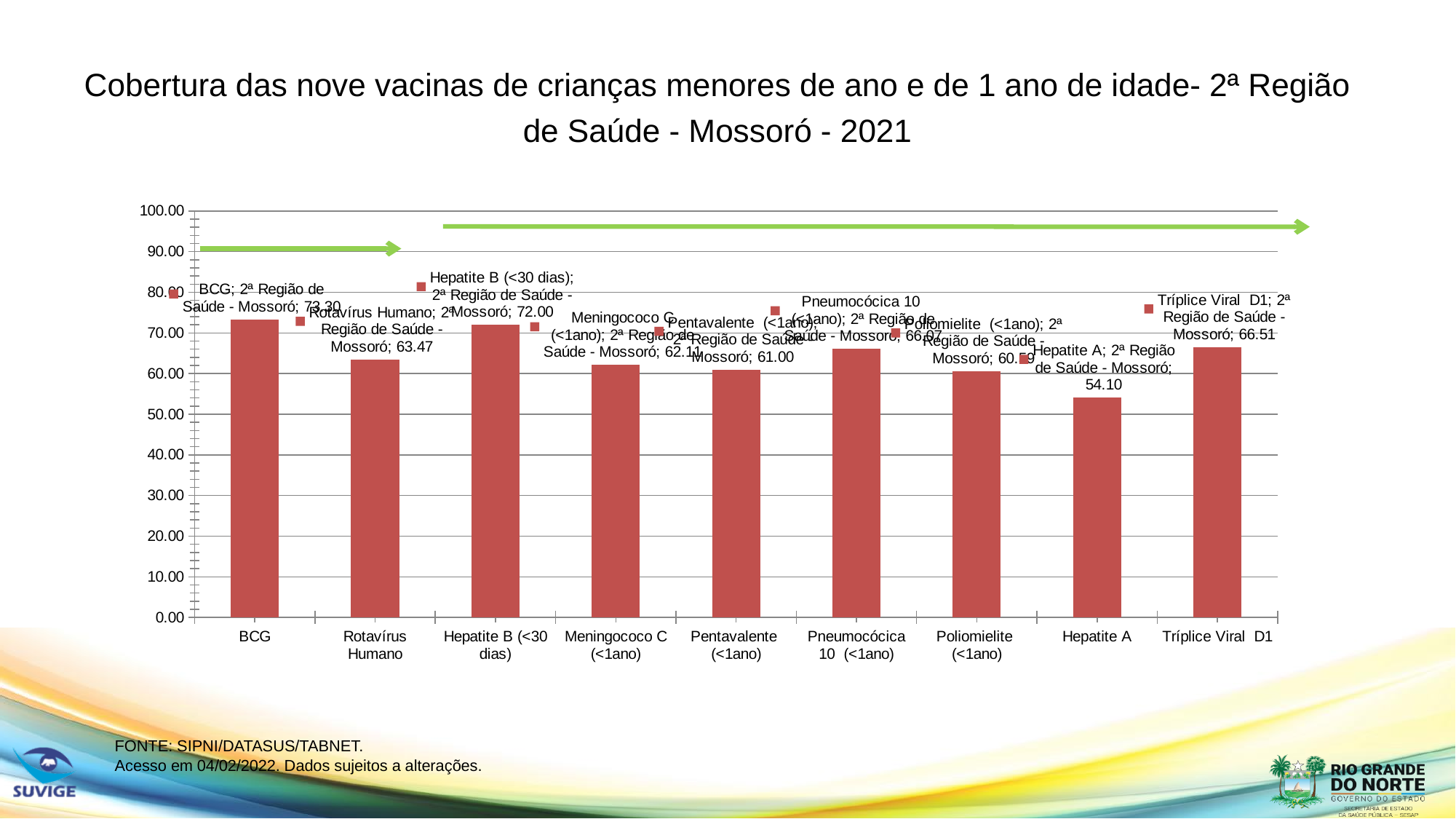
What is the coverage value for Tríplice Viral D1? 66.51 Is the value for Poliomielite (<1ano) greater or less than 70.00? less What is the coverage value for Hepatite A? 54.10 What is the coverage value for Rotavírus Humano? 63.47 Which vaccine has the highest coverage? BCG Which vaccine has the lowest coverage? Hepatite A How many vaccines are shown on the x axis? 9 Which has higher coverage, Pentavalente (<1ano) or Pneumocócica 10 (<1ano)? Pneumocócica 10 (<1ano) What is the coverage value for BCG? 73.30 What is the difference between the coverage for BCG and for Hepatite B (<30 dias)? 1.30 What is the difference between the coverage for BCG and for Hepatite A? 19.20 What kind of chart is shown on the slide? Bar chart